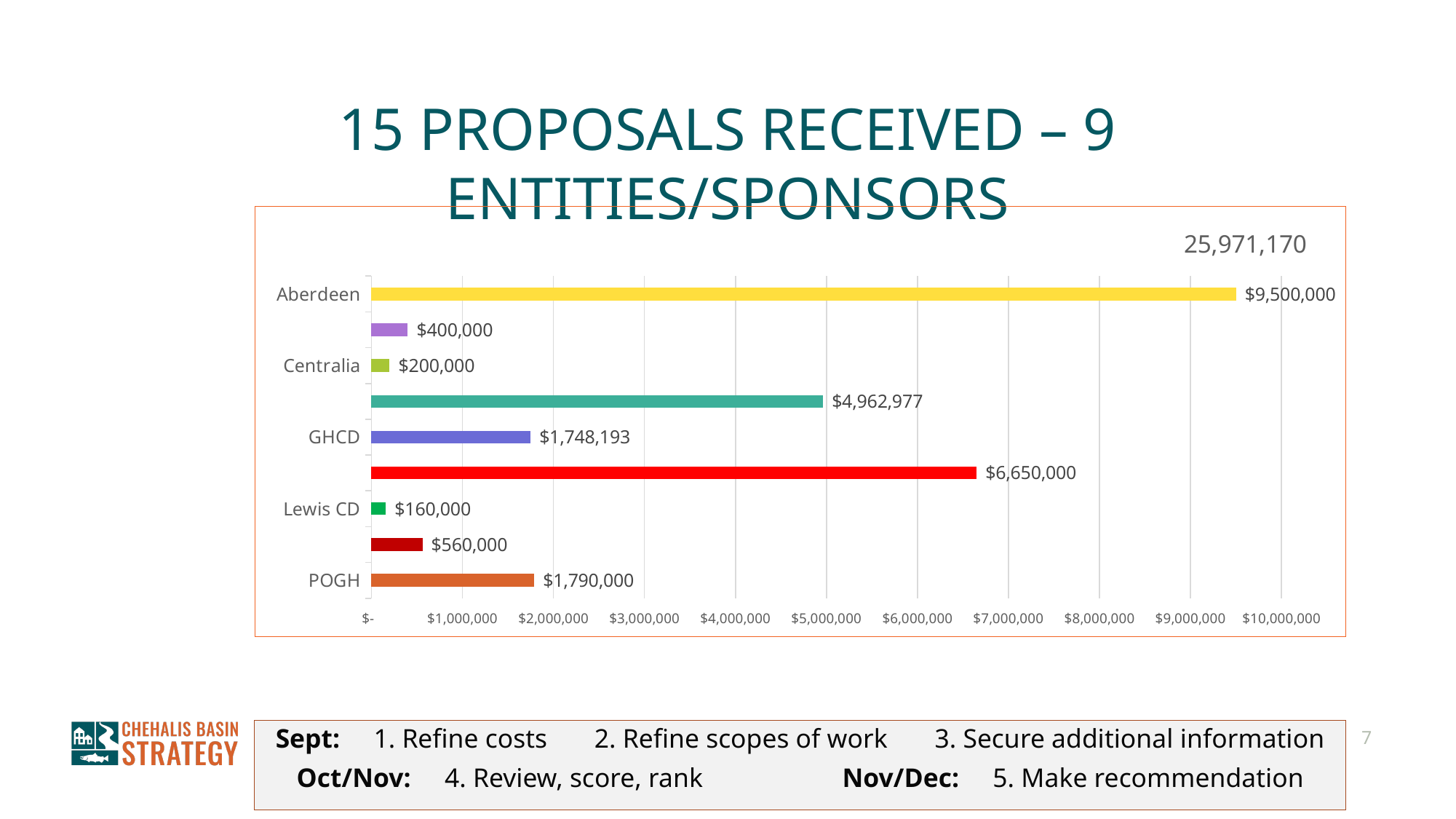
What kind of chart is shown on the slide? bar chart Which labeled entity has the highest value? Aberdeen Which labeled entity has the lowest value? Lewis CD What is the value for Aberdeen? $9,500,000 What is the value for POGH? $1,790,000 Which is larger, the value for POGH or the value for GHCD? POGH What is the difference between the values for Aberdeen and POGH? $7,710,000 What is the value for GHCD? $1,748,193 What is the value for Lewis CD? $160,000 Is the value for Aberdeen greater or less than $9,000,000? greater What is the value for Centralia? $200,000 How many bars are plotted in the chart? 9